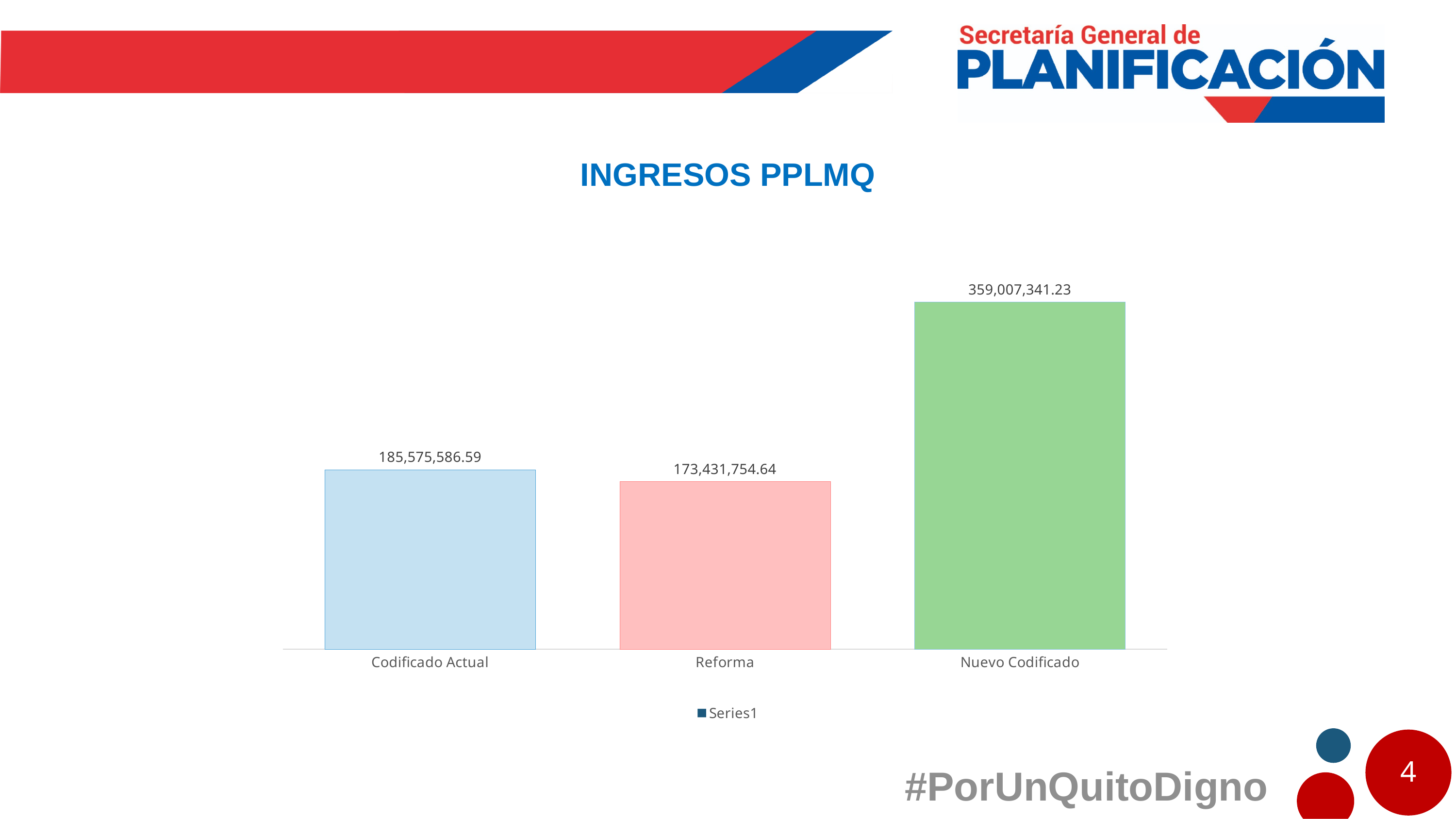
How many categories are shown on the x axis? 3 Which category has the lowest value? Reforma What is the value for Reforma? 173,431,754.64 What kind of chart is shown on the slide? Bar chart What is the value for Nuevo Codificado? 359,007,341.23 How many series does the legend list? 1 What is the title of the chart? INGRESOS PPLMQ What is the difference between the values for Nuevo Codificado and Codificado Actual? 173,431,754.64 Which is larger, the value for Codificado Actual or the value for Reforma? Codificado Actual What is the difference between the values for Codificado Actual and Reforma? 12,143,831.95 What is the value for Codificado Actual? 185,575,586.59 Which category has the highest value? Nuevo Codificado